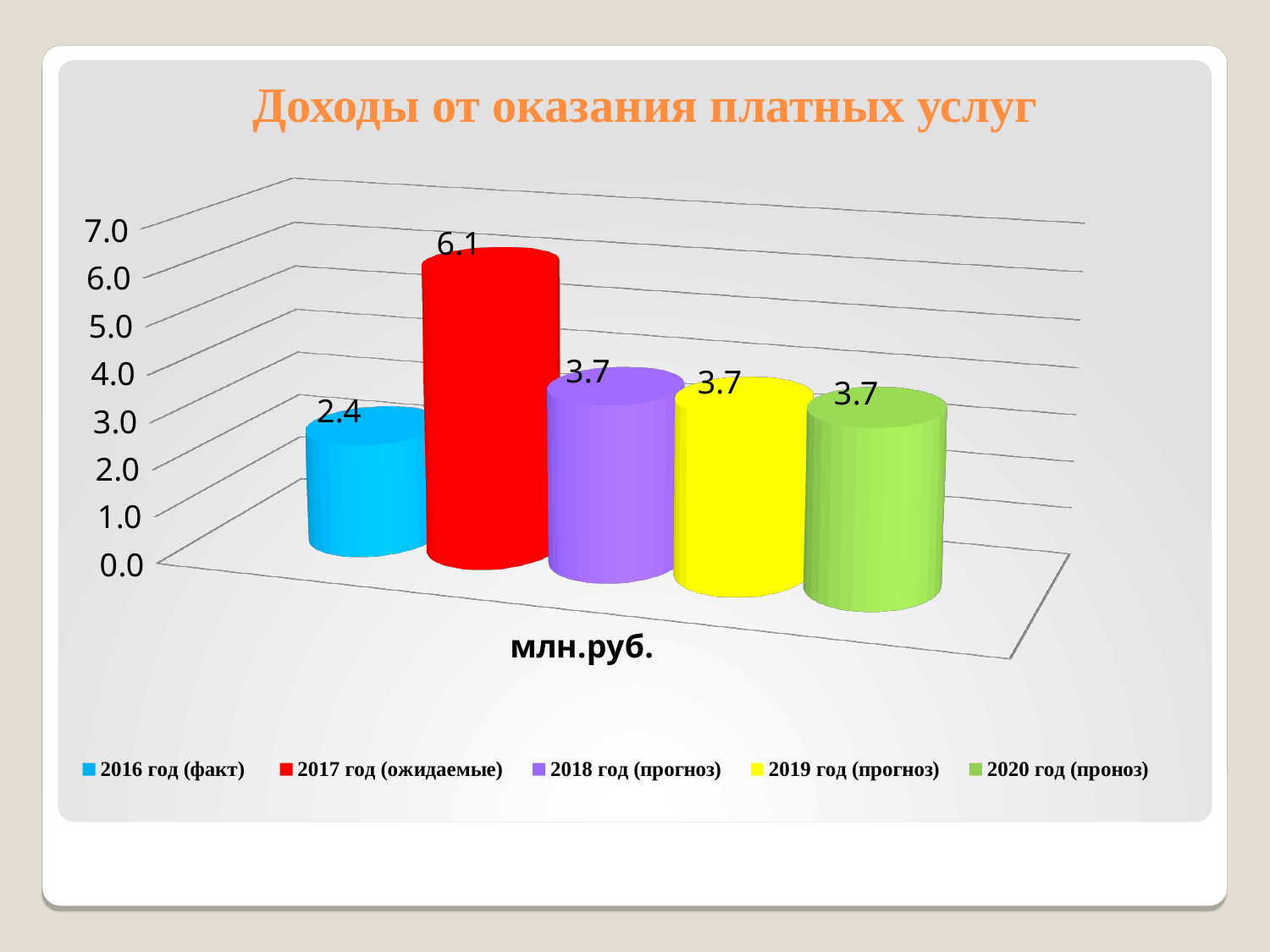
What is the value for 2017 год (ожидаемые)? 6.1 What is the title of the chart? Доходы от оказания платных услуг What kind of chart is shown on the slide? Bar chart Which is larger, the value for 2016 год (факт) or the value for 2019 год (прогноз)? 2019 год (прогноз) How many series does the legend list? 5 Which series has the highest value? 2017 год (ожидаемые) What is the difference between the values for 2017 год (ожидаемые) and 2016 год (факт)? 3.7 What is the value for 2020 год (проноз)? 3.7 What is the difference between the values for 2017 год (ожидаемые) and 2018 год (прогноз)? 2.4 What is the value for 2016 год (факт)? 2.4 Which series has the lowest value? 2016 год (факт) What is the value for 2018 год (прогноз)? 3.7